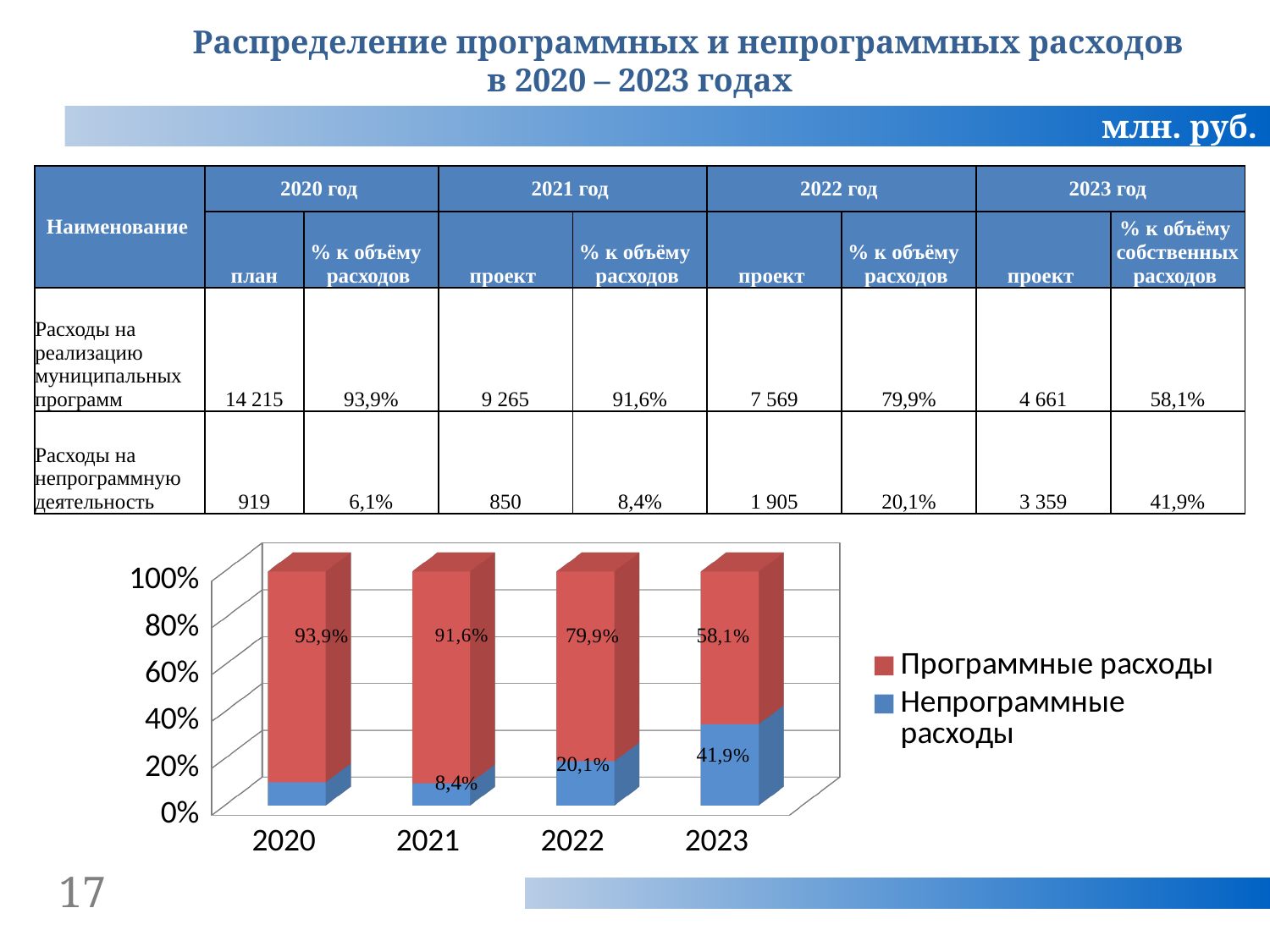
What is the value of Непрограммные расходы for 2023 in the chart? 41,9% In which year is the share of Программные расходы lowest in the chart? 2023 What is the value of Программные расходы for 2020 in the chart? 93,9% What kind of chart is shown on the slide? Stacked bar chart What is the difference between the Программные расходы shares for 2021 and 2022 in the chart? 11,7% In which year is the share of Непрограммные расходы highest in the chart? 2023 Does the share of Программные расходы rise or fall from 2020 to 2023 in the chart? Fall What is the value of Программные расходы for 2022 in the chart? 79,9% How many years are shown on the x axis of the chart? 4 What is the value of Непрограммные расходы for 2021 in the chart? 8,4% How many series does the chart legend list? 2 Is the value of Непрограммные расходы for 2020 greater or less than 20%? less